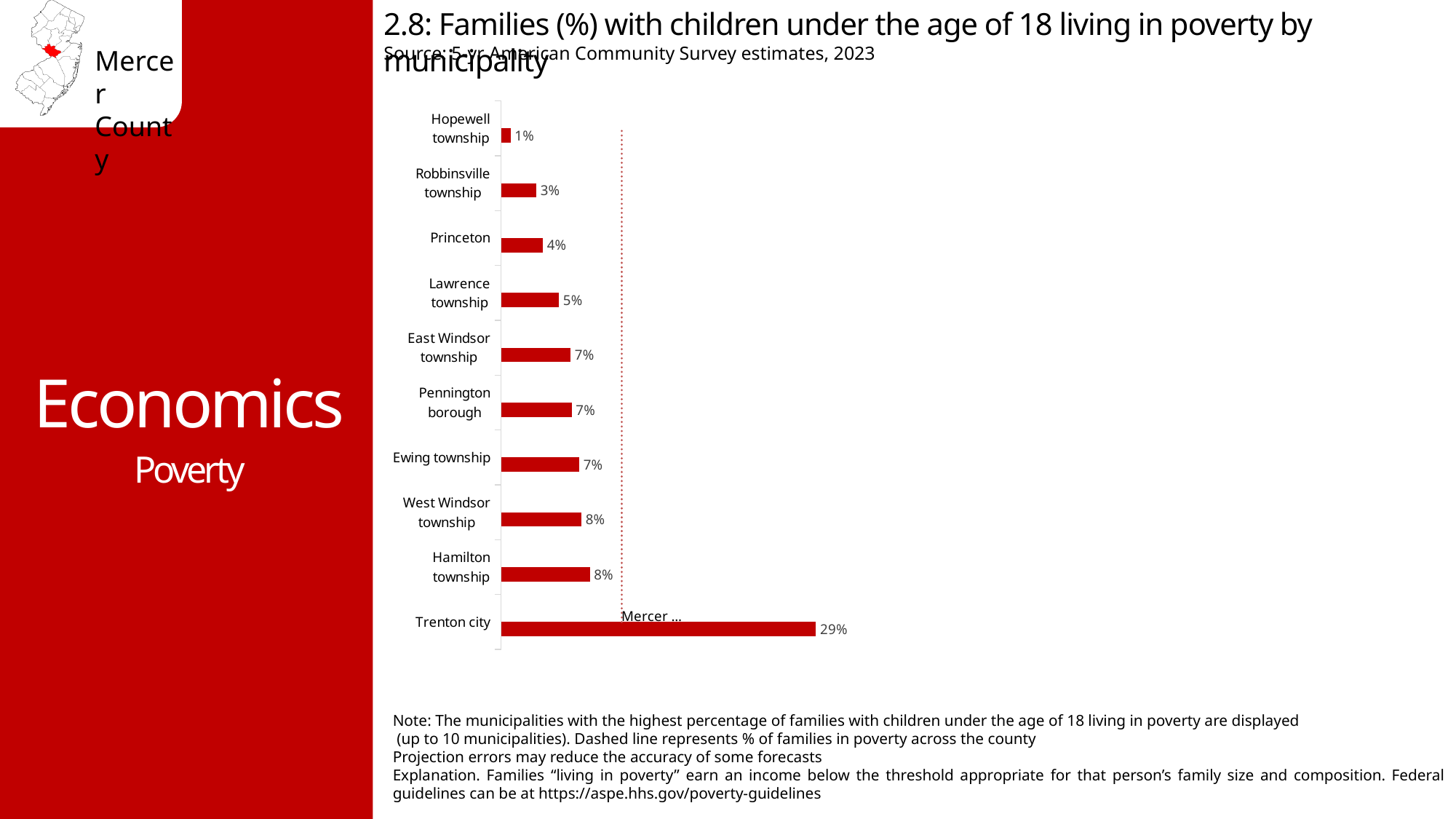
What is the value for Lawrence township? 5% What is the value for Princeton? 4% Which municipality has the highest percentage of families with children under 18 living in poverty? Trenton city What is the value for Trenton city? 29% What is the difference between the values for West Windsor township and Robbinsville township? 5% What kind of chart is shown on the slide? Bar chart How many municipalities are shown in the chart? 10 What is the difference between the values for Trenton city and Hamilton township? 21% Which municipality has the lowest percentage of families with children under 18 living in poverty? Hopewell township What does the dashed line in the chart represent? % of families in poverty across the county What is the value for Hopewell township? 1% Which is larger, the value for Ewing township or the value for Princeton? Ewing township